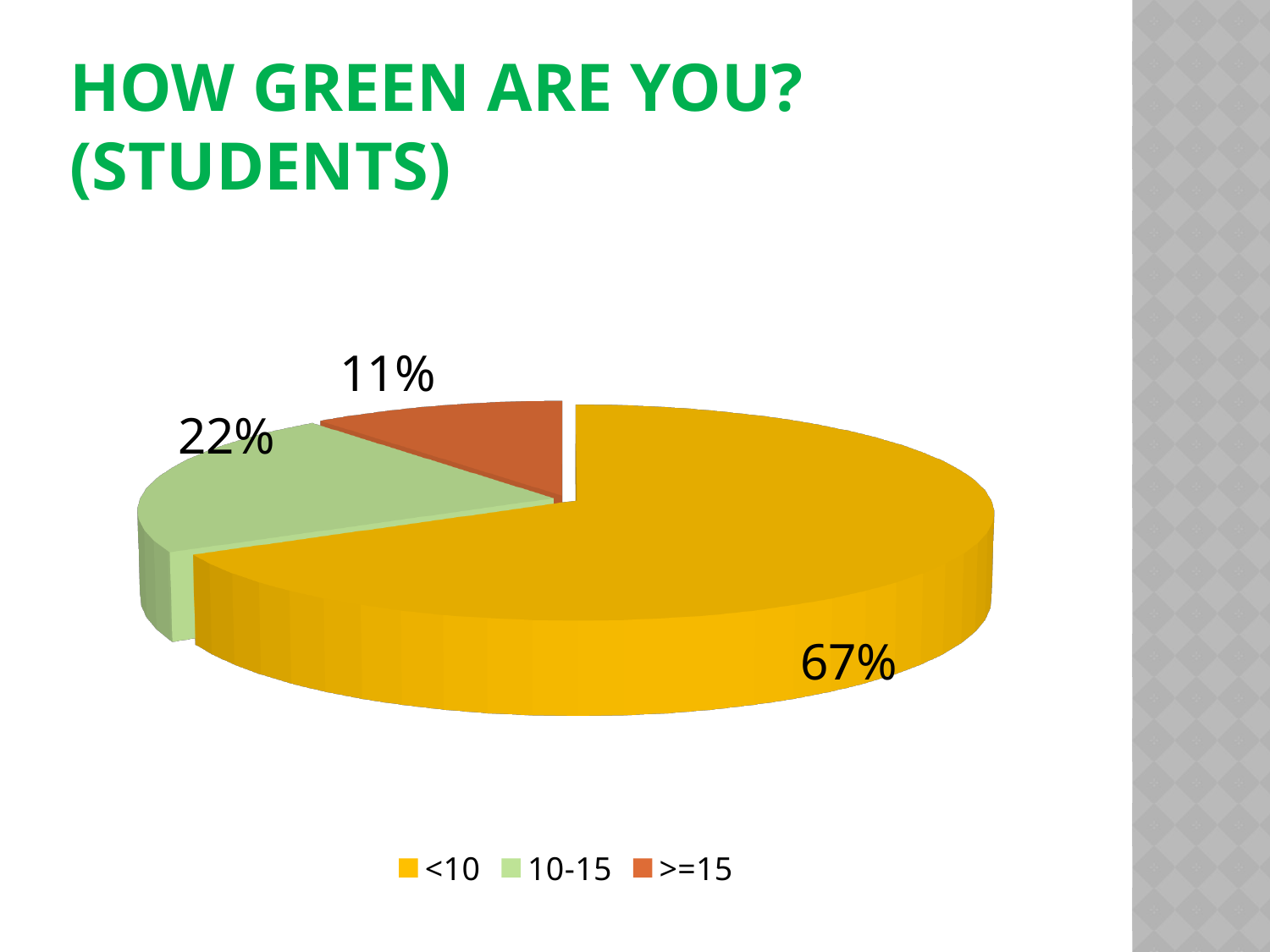
What is the difference in percentage points between the <10 slice and the 10-15 slice? 45 What kind of chart is shown on the slide? pie chart What share of the pie does the <10 category have? 67% Which is larger, the 10-15 slice or the >=15 slice? 10-15 What colour is the slice for the <10 category? yellow How many categories does the pie chart have? 3 What is the title of the slide containing the chart? HOW GREEN ARE YOU? (STUDENTS) Which category has the smallest slice of the pie? >=15 What share of the pie does the 10-15 category have? 22% What share of the pie does the >=15 category have? 11% What is the difference in percentage points between the 10-15 slice and the >=15 slice? 11 Which category has the largest slice of the pie? <10